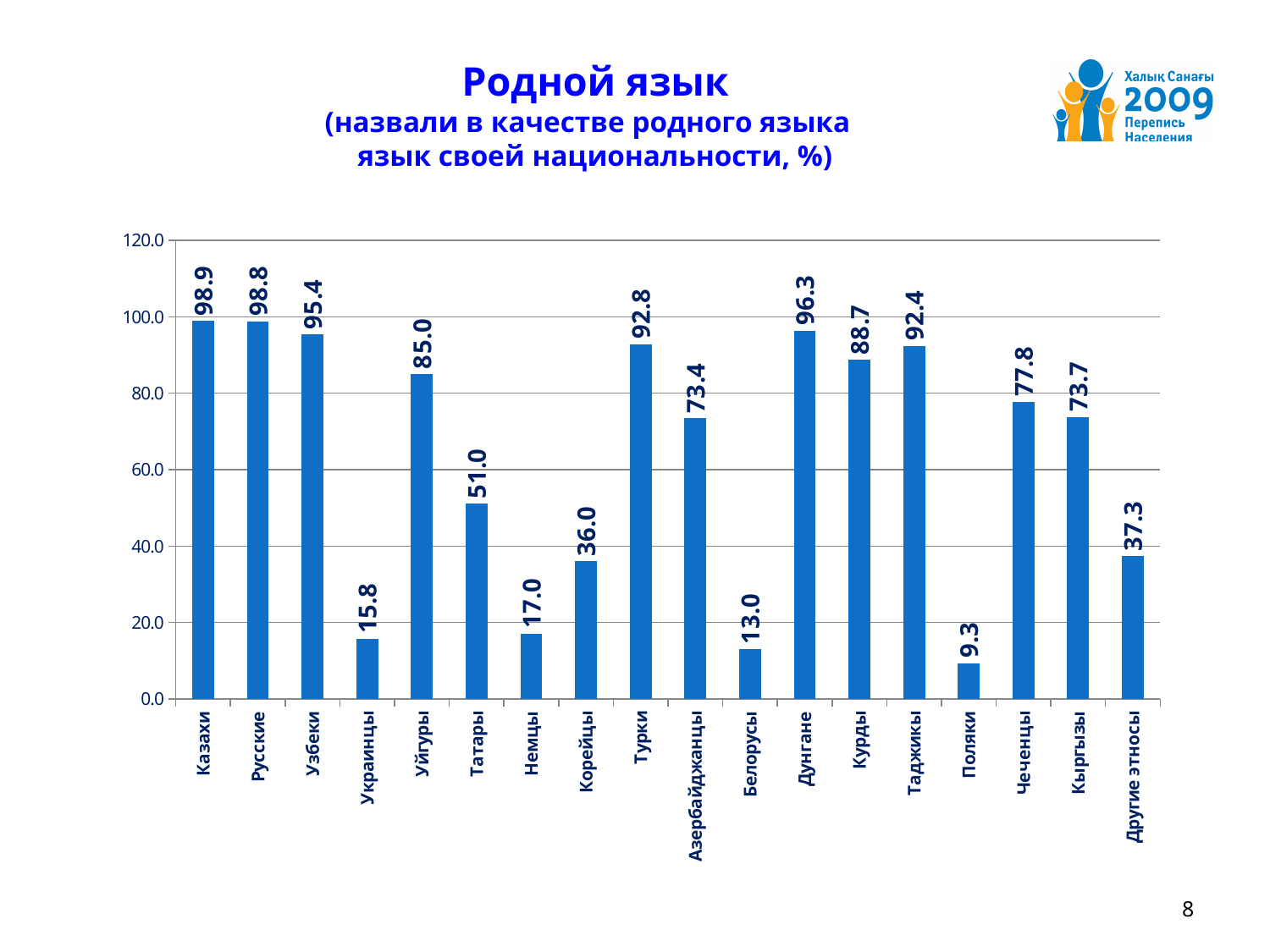
Is the value for Чеченцы greater or less than 60? greater How many categories are shown on the x axis? 18 What value is shown for Другие этносы? 37.3 What value is shown for Казахи? 98.9 Which is larger, the value for Дунгане or the value for Курды? Дунгане What kind of chart is shown on the slide? bar chart Which category has the lowest value? Поляки What value is shown for Дунгане? 96.3 What value is shown for Белорусы? 13.0 What is the difference between the values for Уйгуры and Татары? 34.0 Is the value for Корейцы greater or less than 40? less What is the main title of the chart on the slide? Родной язык